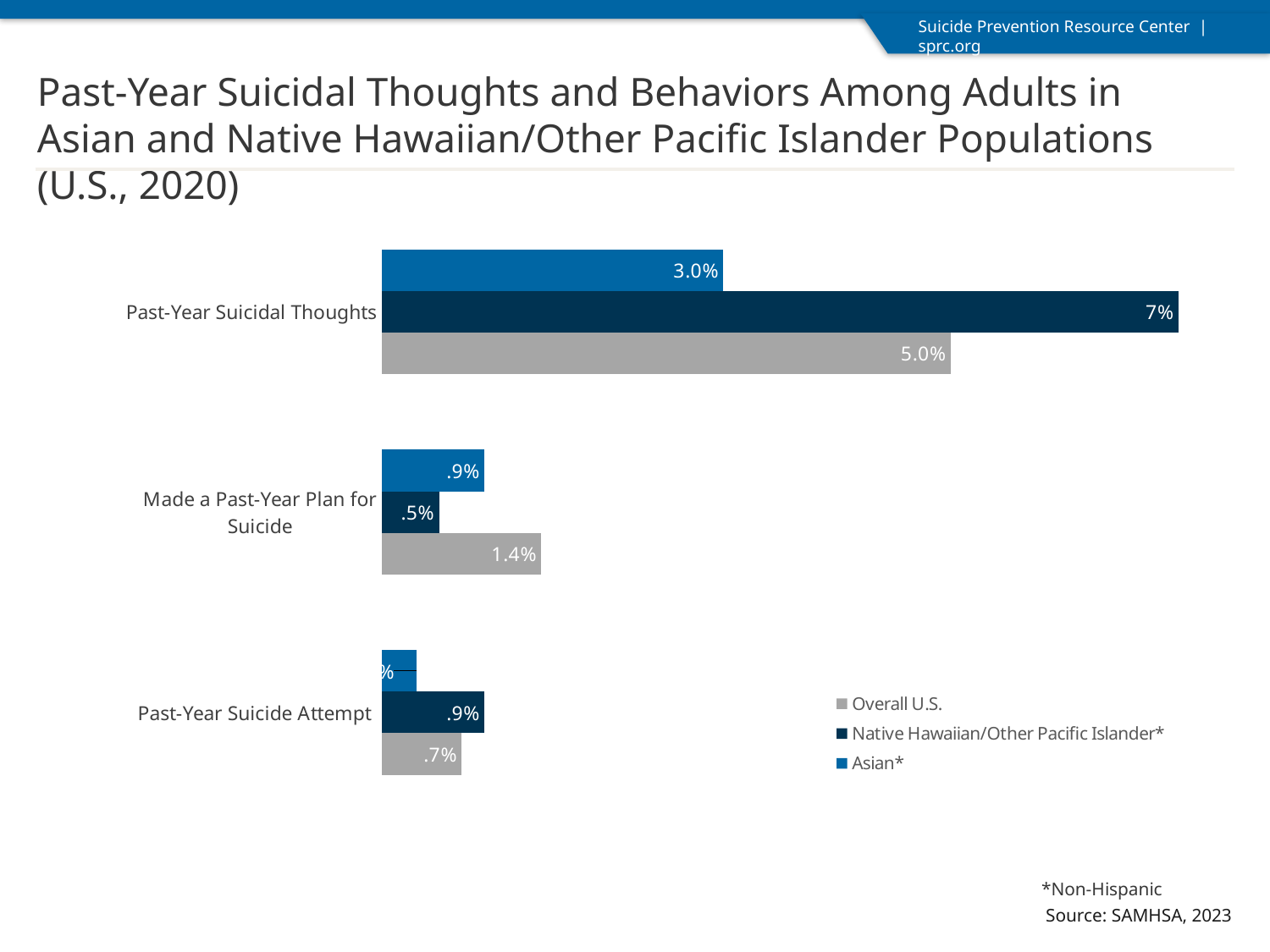
How many series does the legend list? 3 Which series has the lowest value for Made a Past-Year Plan for Suicide? Native Hawaiian/Other Pacific Islander* For Past-Year Suicide Attempt, which is larger: the Overall U.S. value or the Native Hawaiian/Other Pacific Islander value? Native Hawaiian/Other Pacific Islander* What is the value for Asian for Past-Year Suicidal Thoughts? 3.0% What is the Overall U.S. value for Made a Past-Year Plan for Suicide? 1.4% What is the value for Native Hawaiian/Other Pacific Islander for Past-Year Suicidal Thoughts? 7% What is the value for Native Hawaiian/Other Pacific Islander for Past-Year Suicide Attempt? .9% What kind of chart is shown on the slide? bar chart Which series is shown in gray in the legend? Overall U.S. Which series has the highest value for Past-Year Suicidal Thoughts? Native Hawaiian/Other Pacific Islander* How many categories are shown on the chart? 3 What is the difference between the Overall U.S. and Asian values for Past-Year Suicidal Thoughts? 2.0%